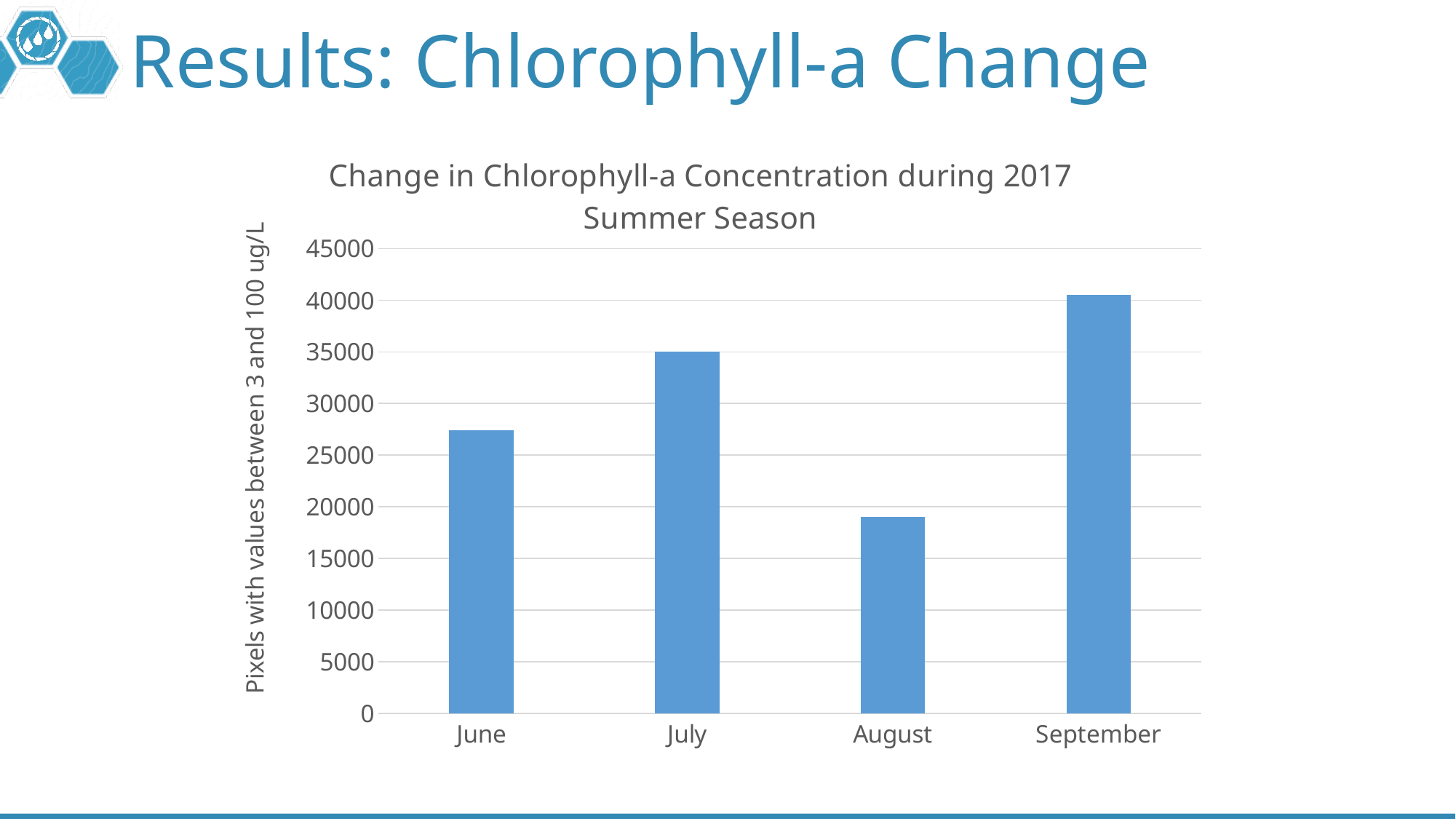
Is the value for July greater or less than 30000? greater Which month has the lowest value in the chart? August How many months are plotted on the x axis? 4 What kind of chart is shown on the slide? bar chart What is the title of the chart? Change in Chlorophyll-a Concentration during 2017 Summer Season Which is larger, the value for July or the value for September? September What is the label of the vertical axis? Pixels with values between 3 and 100 ug/L Which month has the highest value in the chart? September Is the value for June greater or less than 25000? greater Is the value for August greater or less than 20000? less Which is larger, the value for June or the value for August? June